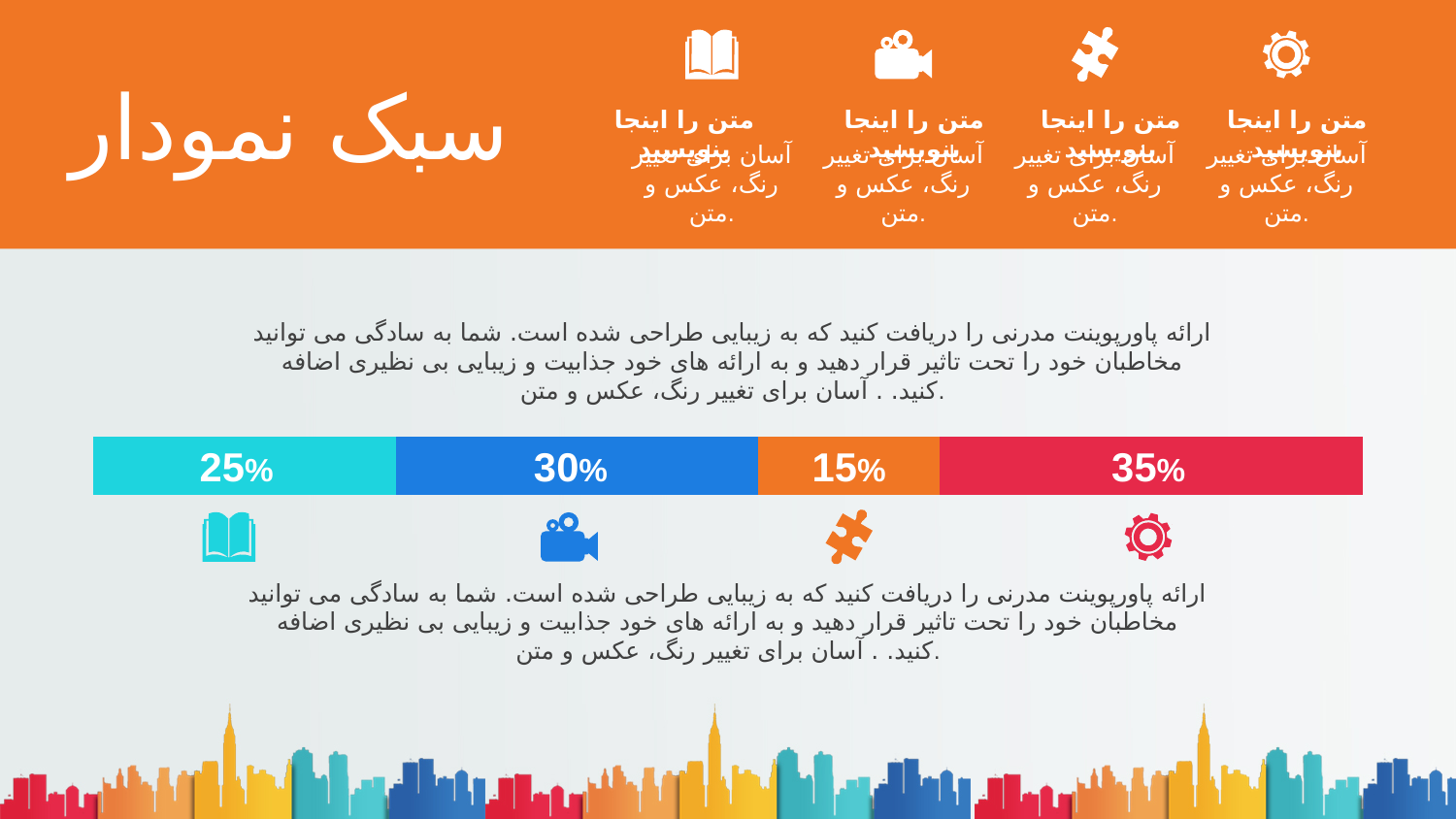
What value is shown on the red (rightmost) segment of the bar? 35% What value is shown on the blue segment of the bar? 30% Which segment of the bar has the highest value? the red segment (35%) Which segment of the bar has the lowest value? the orange segment (15%) What value is shown on the orange segment of the bar? 15% How many segments does the bar contain? 4 Which is larger, the blue segment or the cyan segment? the blue segment Which icon appears below the red 35% segment? a gear icon What is the total of all four segments of the bar? 105% What kind of chart is shown on the slide? a horizontal stacked bar chart What value is shown on the cyan (leftmost) segment of the bar? 25% What is the difference between the red segment and the orange segment? 20%